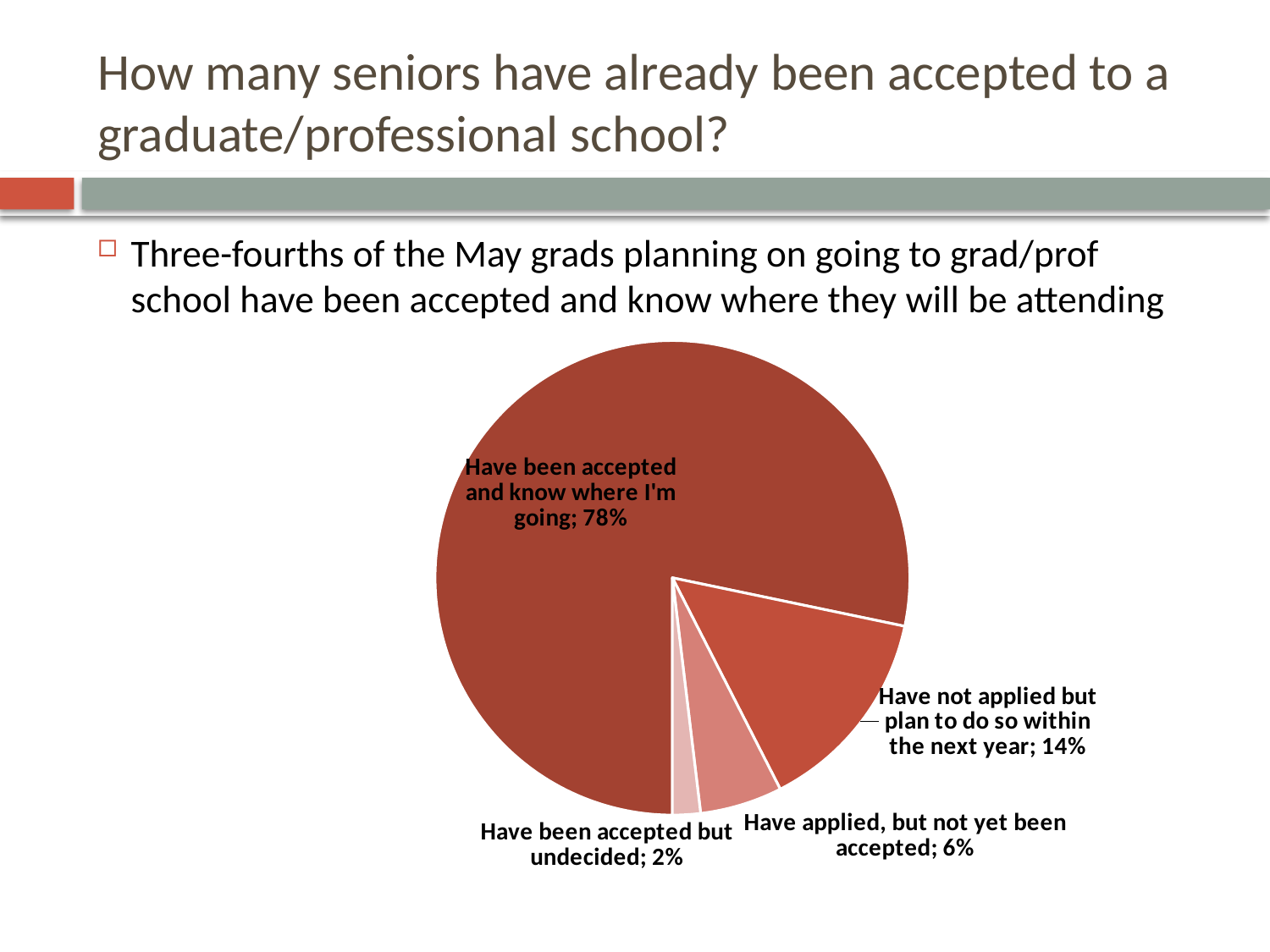
What is the title of the slide containing the pie chart? How many seniors have already been accepted to a graduate/professional school? What is the difference in percentage points between 'Have been accepted and know where I'm going' and 'Have not applied but plan to do so within the next year'? 64 What percentage of seniors have not applied but plan to do so within the next year? 14% Which category has the smallest share of the pie? Have been accepted but undecided Which category has the largest share of the pie? Have been accepted and know where I'm going What percentage of seniors have applied but not yet been accepted? 6% What percentage of seniors have been accepted and know where they are going? 78% How many slices does the pie chart have? 4 What is the combined share of 'Have applied, but not yet been accepted' and 'Have been accepted but undecided'? 8% What kind of chart is shown on the slide? pie chart Which is larger: the share for 'Have applied, but not yet been accepted' or the share for 'Have been accepted but undecided'? Have applied, but not yet been accepted What percentage of seniors have been accepted but are undecided? 2%